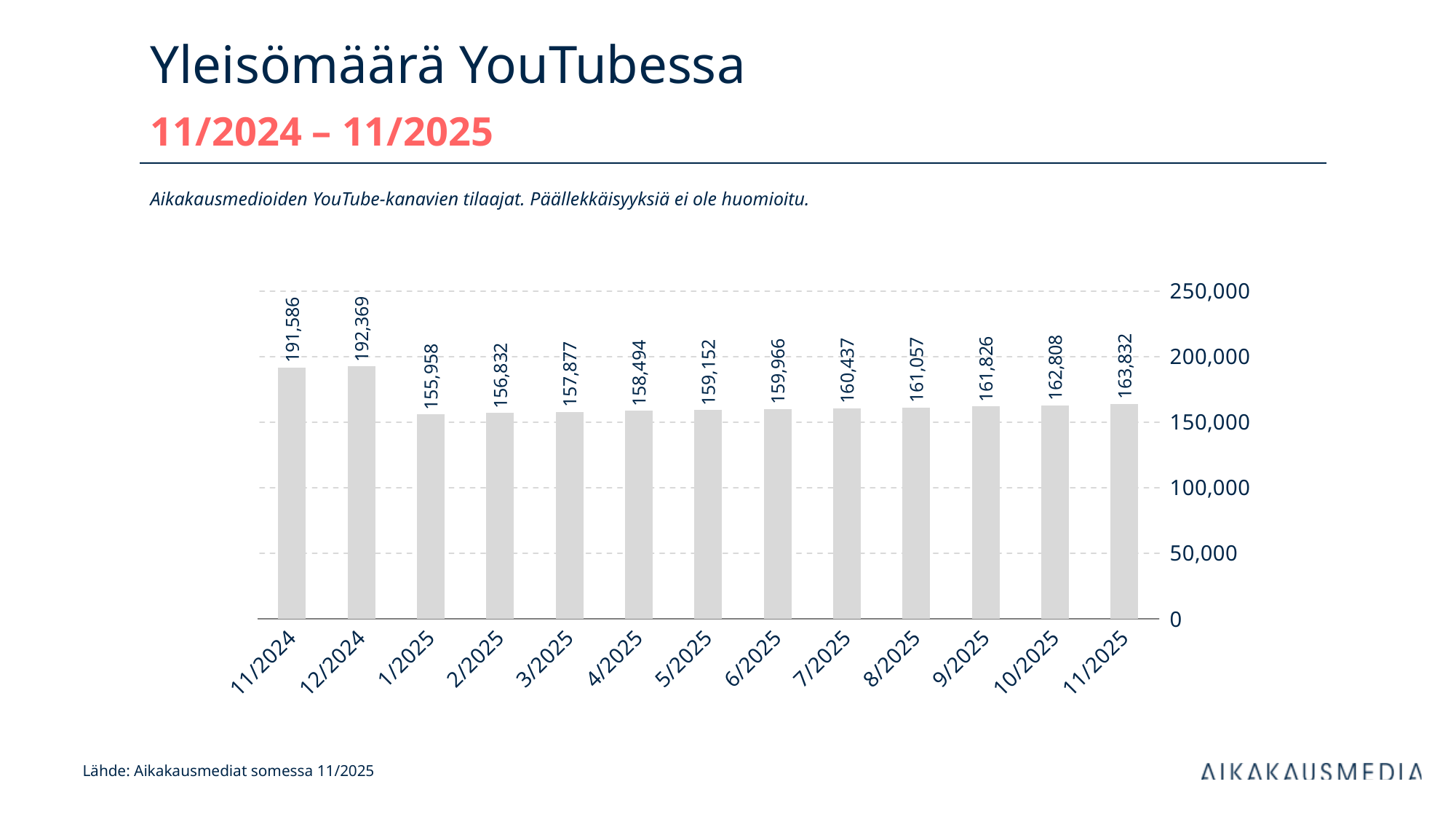
What is the difference between the values for 11/2025 and 11/2024? 27,754 How many months are shown on the x axis? 13 What is the value for 11/2024? 191,586 What is the difference between the values for 12/2024 and 1/2025? 36,411 What is the value for 5/2025? 159,152 Which is larger, the value for 3/2025 or the value for 9/2025? 9/2025 Do the values rise or fall from 1/2025 to 11/2025? Rise What kind of chart is shown on the slide? Bar chart Which month has the lowest value? 1/2025 What is the value for 11/2025? 163,832 Which month has the highest value? 12/2024 Is the value for 12/2024 greater or less than 150,000? greater